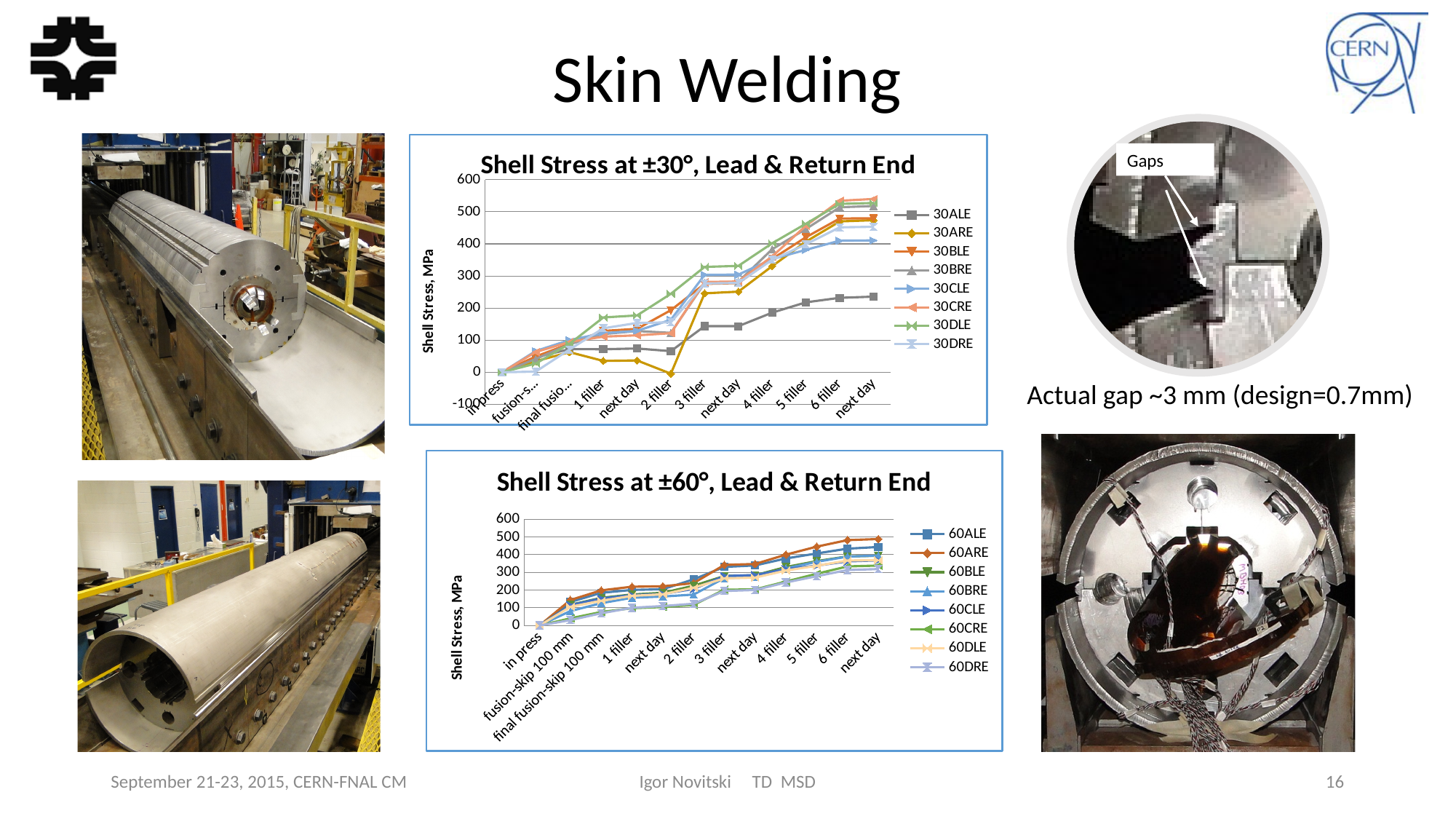
How many categories are on the x axis of the 'Shell Stress at ±60°, Lead & Return End' chart? 12 In the 'Shell Stress at ±60°, Lead & Return End' chart, which series has the highest value at the final 'next day' point? 60ARE In the 'Shell Stress at ±60°, Lead & Return End' chart, do the series values generally rise or fall from 'in press' to the final 'next day'? rise In the 'Shell Stress at ±30°, Lead & Return End' chart, which series has the lowest value at the final 'next day' point? 30ALE What is the title of the upper chart on the slide? Shell Stress at ±30°, Lead & Return End How many series does the legend of the 'Shell Stress at ±60°, Lead & Return End' chart list? 8 What is the y-axis label of the 'Shell Stress at ±60°, Lead & Return End' chart? Shell Stress, MPa What type of chart is the 'Shell Stress at ±30°, Lead & Return End' chart? line chart How many series does the legend of the 'Shell Stress at ±30°, Lead & Return End' chart list? 8 In the 'Shell Stress at ±60°, Lead & Return End' chart, is the value for 60ARE at the final 'next day' point greater or less than 400? greater In the 'Shell Stress at ±30°, Lead & Return End' chart, is the value for 30ALE at the final 'next day' point greater or less than 300? less In the 'Shell Stress at ±30°, Lead & Return End' chart, is the value for 30ARE at '2 filler' greater or less than 100? less